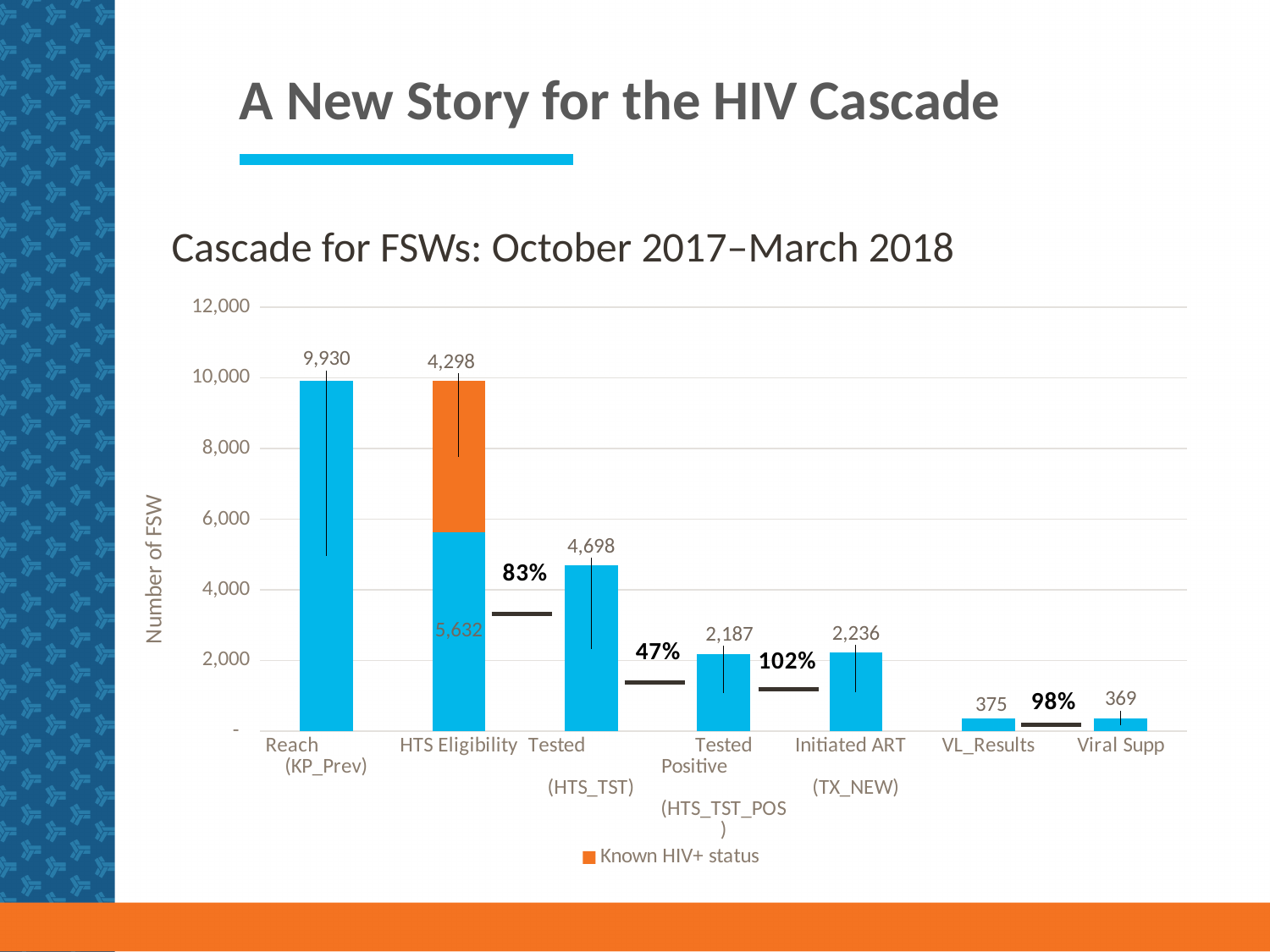
Which category has the lowest value? Viral Supp What is the value for Tested (HTS_TST)? 4,698 How many categories are shown on the x axis? 7 What is the title of the y axis? Number of FSW What is the difference between Tested (HTS_TST) and Tested Positive (HTS_TST_POS)? 2,511 Is the value for Tested (HTS_TST) greater or less than 4,000? greater What is the total of the stacked HTS Eligibility bar (5,632 plus 4,298)? 9,930 What percentage is shown between Tested and Tested Positive? 47% What is the Known HIV+ status portion of the HTS Eligibility bar? 4,298 What is the value for Reach (KP_Prev)? 9,930 What is the value for Initiated ART (TX_NEW)? 2,236